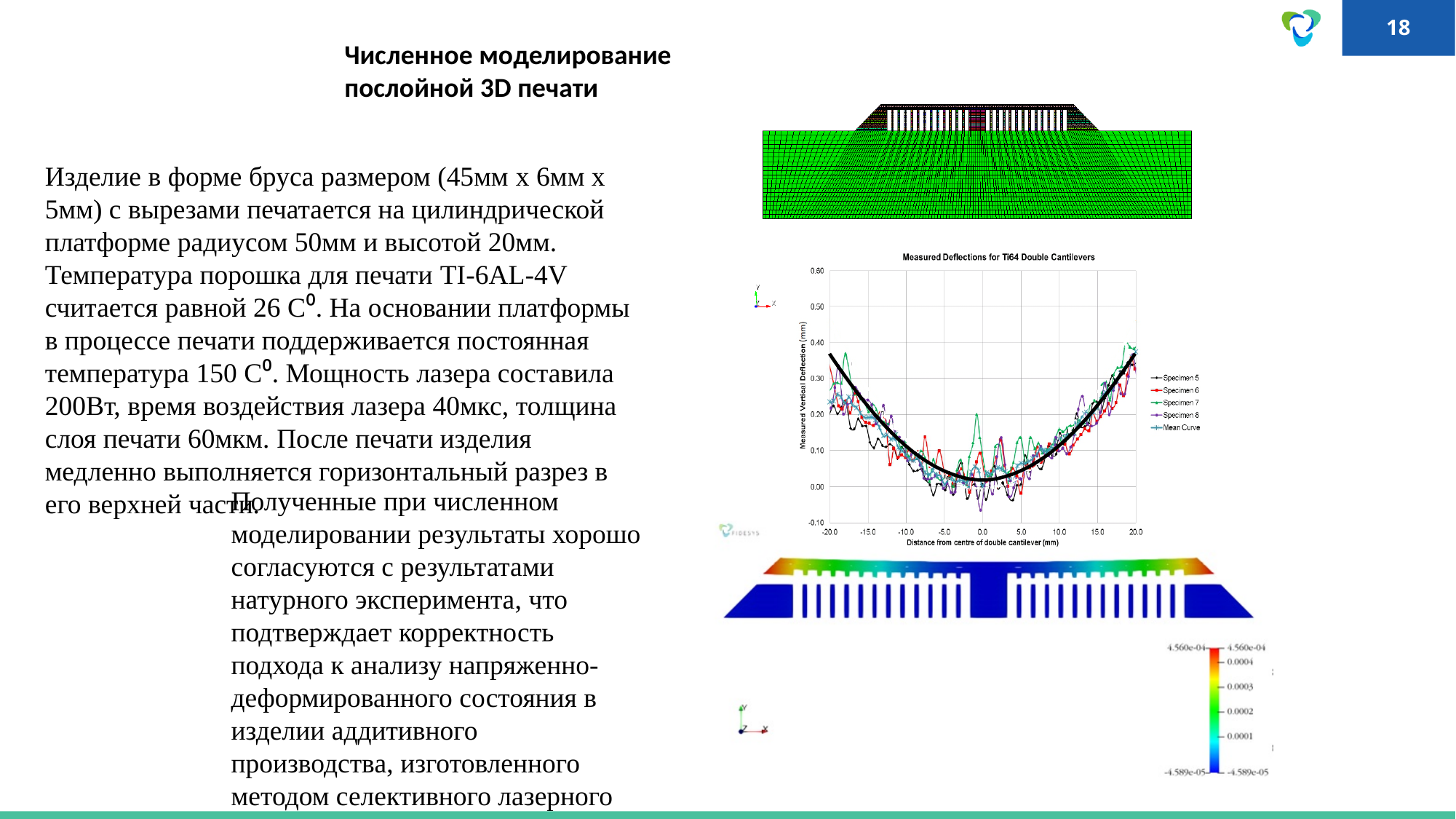
What kind of chart is shown under the title "Measured Deflections for Ti64 Double Cantilevers"? line chart In the "Measured Deflections for Ti64 Double Cantilevers" chart, is the Mean Curve value at a distance of 20.0 mm greater or less than 0.20? greater In the "Measured Deflections for Ti64 Double Cantilevers" chart, do the Mean Curve values rise or fall as the distance goes from -20.0 mm to 0.0 mm? fall In the "Measured Deflections for Ti64 Double Cantilevers" chart, is the Mean Curve value at a distance of -20.0 mm greater or less than 0.30? less In the "Measured Deflections for Ti64 Double Cantilevers" chart, which is larger: the Mean Curve value at -20.0 mm or at 0.0 mm? -20.0 mm What is the highest tick value shown on the y axis of the "Measured Deflections for Ti64 Double Cantilevers" chart? 0.60 What is the lowest tick value shown on the y axis of the "Measured Deflections for Ti64 Double Cantilevers" chart? -0.10 In the "Measured Deflections for Ti64 Double Cantilevers" chart, do the Mean Curve values rise or fall as the distance goes from 0.0 mm to 20.0 mm? rise What is the label of the x axis of the "Measured Deflections for Ti64 Double Cantilevers" chart? Distance from centre of double cantilever (mm) How many series does the legend of the "Measured Deflections for Ti64 Double Cantilevers" chart list? 5 What is the title of the line chart on the slide? Measured Deflections for Ti64 Double Cantilevers In the "Measured Deflections for Ti64 Double Cantilevers" chart, is the Mean Curve value at a distance of 0.0 mm greater or less than 0.10? less